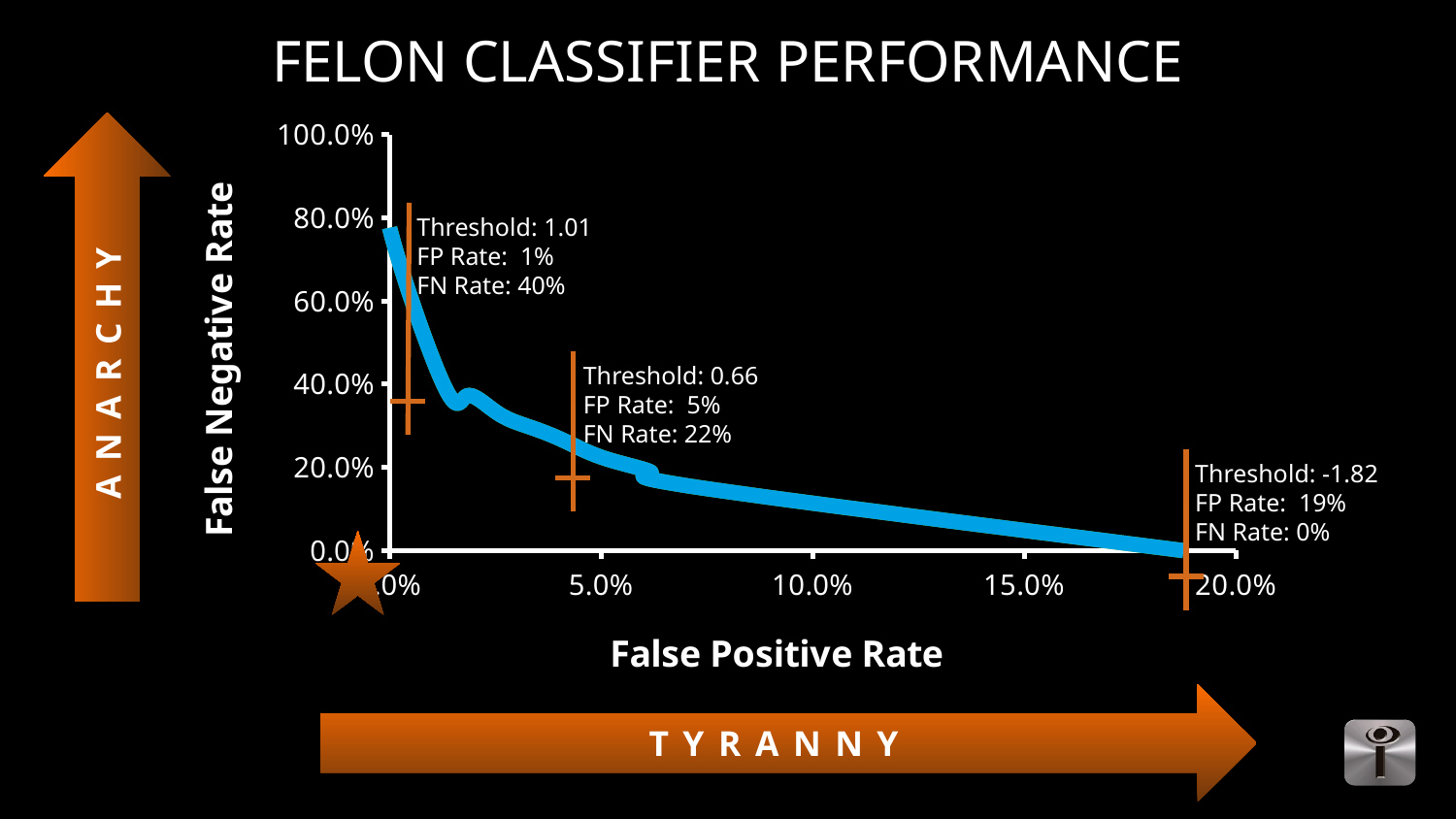
What is the label of the vertical axis? False Negative Rate What is the FN Rate at Threshold 1.01? 40% Which annotated threshold has the higher FP Rate, 0.66 or -1.82? -1.82 What is the title of the chart? FELON CLASSIFIER PERFORMANCE Which annotated threshold has the highest FN Rate? 1.01 What is the difference between the FN Rate at Threshold 1.01 and the FN Rate at Threshold 0.66? 18% What is the FN Rate at Threshold -1.82? 0% What kind of chart is shown on the slide? line chart As the False Positive Rate increases along the x axis, does the False Negative Rate rise or fall? fall What is the FP Rate at Threshold 0.66? 5% What is the FP Rate at Threshold 1.01? 1% How many threshold annotations are marked on the curve? 3